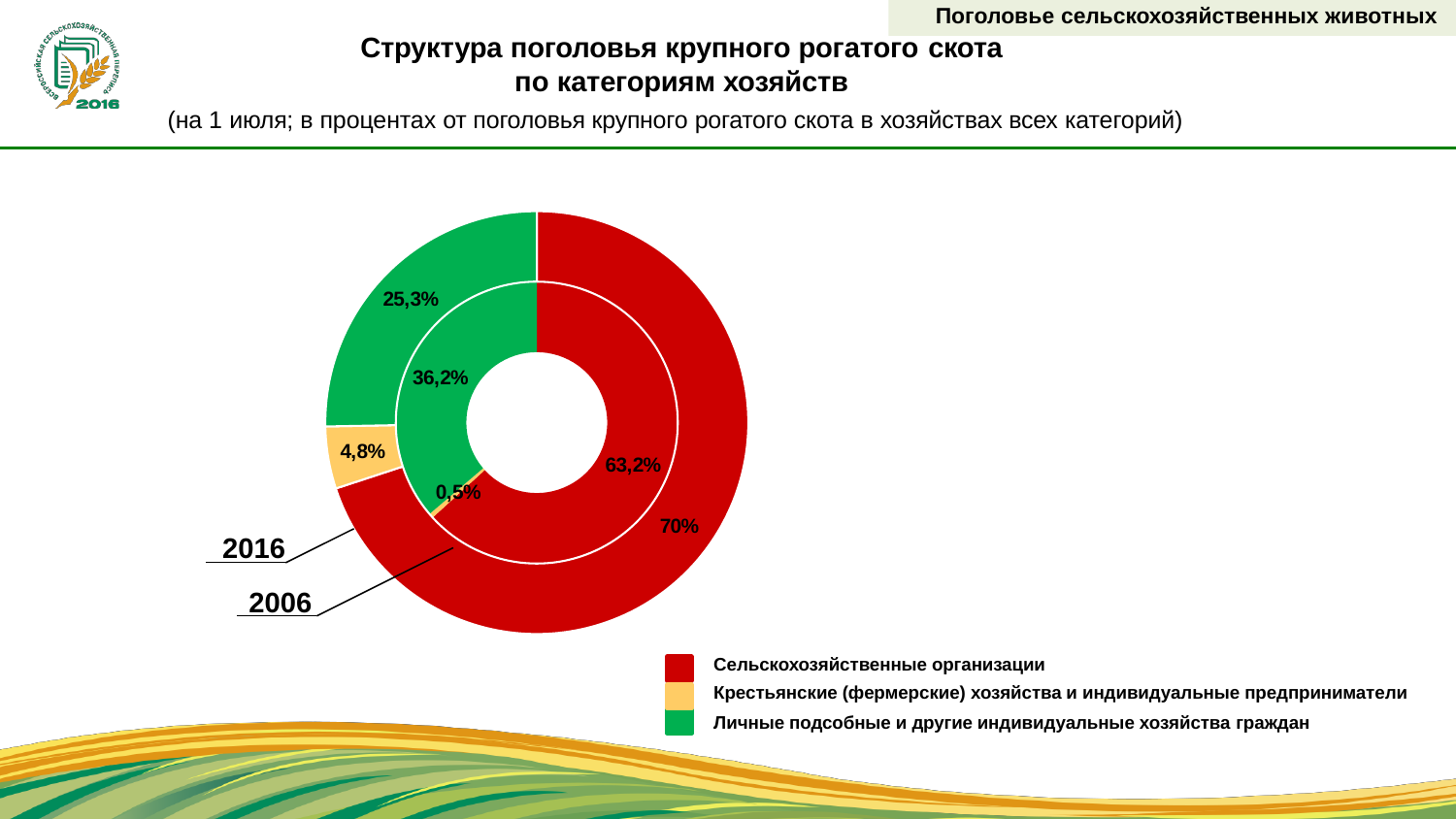
What share of cattle was held by personal subsidiary and other individual holdings of citizens in 2006? 36,2% How many categories of holdings does the legend list? 3 Which category of holdings had the largest share of cattle in 2016? Сельскохозяйственные организации By how many percentage points did the share of agricultural organisations change from 2006 to 2016? 6,8 What share of cattle was held by agricultural organisations (Сельскохозяйственные организации) in 2016? 70% What share of cattle was held by peasant (farm) holdings and individual entrepreneurs in 2016? 4,8% Which category of holdings had the smallest share of cattle in 2006? Крестьянские (фермерские) хозяйства и индивидуальные предприниматели What type of chart is shown on the slide? Doughnut (pie) chart By how many percentage points did the share of personal subsidiary and other individual holdings of citizens fall from 2006 to 2016? 10,9 Which was larger: the share of personal subsidiary holdings in 2006 or in 2016? 2006 What share of cattle was held by agricultural organisations (Сельскохозяйственные организации) in 2006? 63,2% What share of cattle was held by peasant (farm) holdings and individual entrepreneurs in 2006? 0,5%